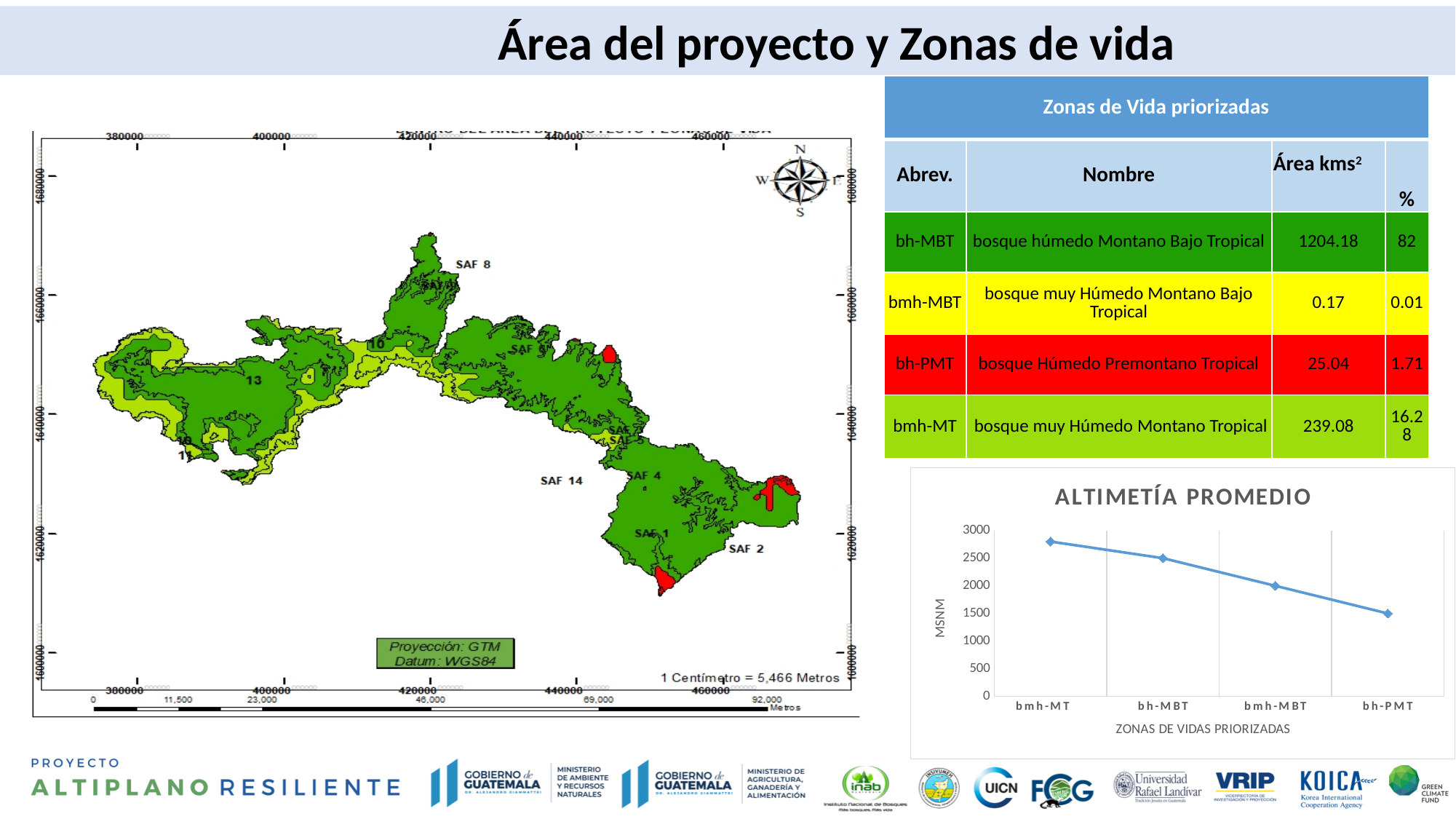
Which life zone has the lowest average altitude in the "ALTIMETÍA PROMEDIO" chart? bh-PMT In the "ALTIMETÍA PROMEDIO" chart, which has a higher value, bh-MBT or bh-PMT? bh-MBT In the "ALTIMETÍA PROMEDIO" chart, is the value for bh-PMT greater or less than 2000? less How many life zones are plotted on the x axis of the "ALTIMETÍA PROMEDIO" chart? 4 Which life zone has the highest average altitude in the "ALTIMETÍA PROMEDIO" chart? bmh-MT In the "ALTIMETÍA PROMEDIO" chart, is the value for bmh-MT greater or less than 2500? greater In the "ALTIMETÍA PROMEDIO" chart, which has a higher value, bmh-MBT or bmh-MT? bmh-MT In the "ALTIMETÍA PROMEDIO" chart, is the value for bmh-MBT greater or less than 1500? greater In the "ALTIMETÍA PROMEDIO" chart, do the values rise or fall from left to right along the x axis? fall What kind of chart is the "ALTIMETÍA PROMEDIO" chart? line chart What is the label on the vertical axis of the "ALTIMETÍA PROMEDIO" chart? MSNM What is the label on the horizontal axis of the "ALTIMETÍA PROMEDIO" chart? ZONAS DE VIDAS PRIORIZADAS